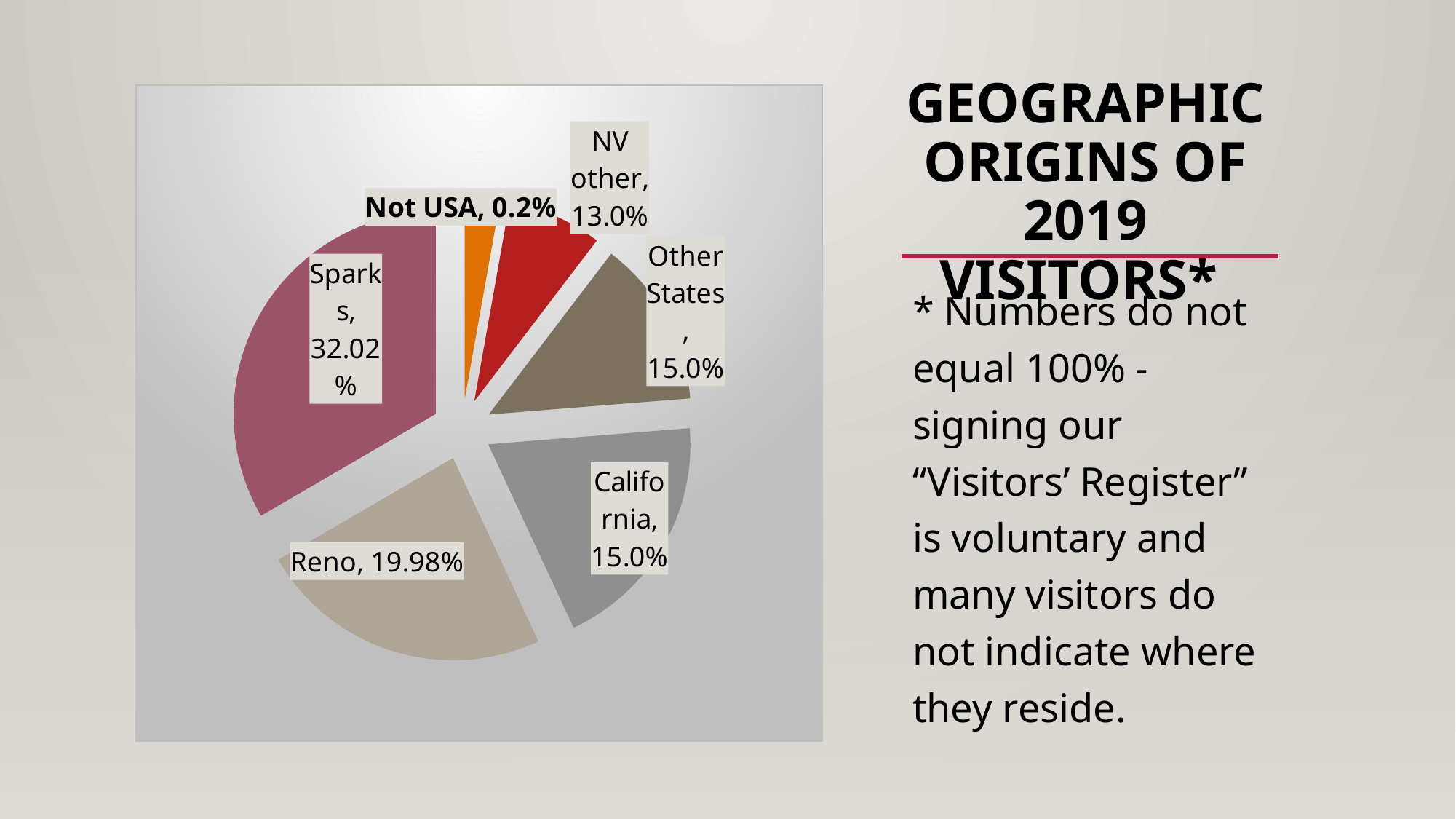
What is the difference in percentage points between Other States and NV other? 2.0 Which category has the largest slice of the pie? Sparks What percentage is shown for Not USA? 0.2% What percentage is shown for Reno? 19.98% Which category has the smallest slice of the pie? Not USA What percentage is shown for NV other? 13.0% What percentage of 2019 visitors came from Sparks? 32.02% What is the title of the slide containing the chart? GEOGRAPHIC ORIGINS OF 2019 VISITORS* What kind of chart is shown on the slide? Pie chart How many slices does the pie chart have? 6 What is the difference in percentage points between Sparks and Reno? 12.04 Which is larger, the Reno slice or the California slice? Reno